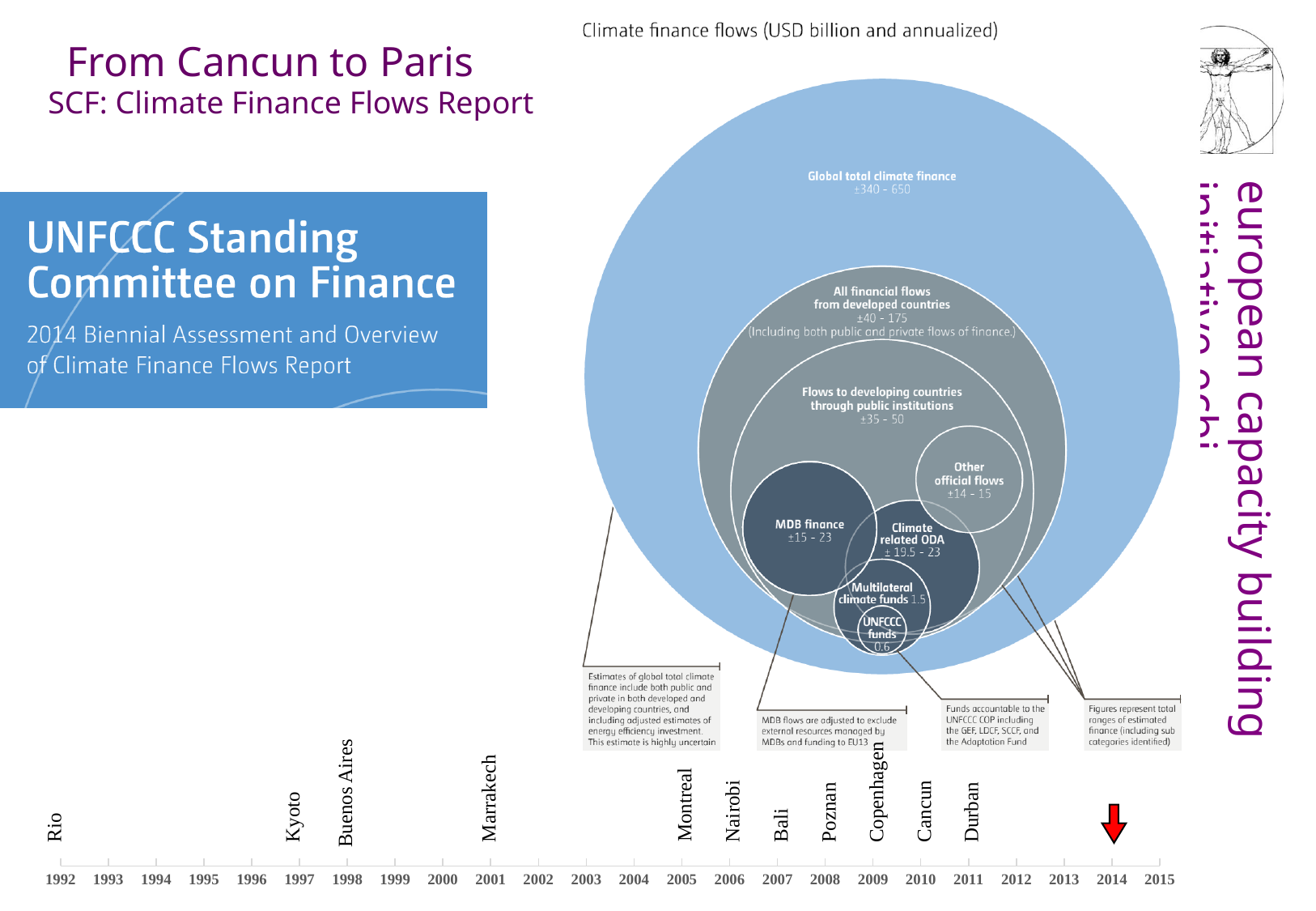
What value is printed for Multilateral climate funds? 1.5 Which is larger, Multilateral climate funds or UNFCCC funds? Multilateral climate funds What range is shown for Flows to developing countries through public institutions? ±35 - 50 What range is printed for All financial flows from developed countries? ±40 - 175 What is the range shown for Global total climate finance in the climate finance flows diagram? ±340 - 650 What range is shown for Climate related ODA? ± 19.5 - 23 In what units are the climate finance flows in the diagram expressed, according to its title? USD billion and annualized What is the difference between the Multilateral climate funds value and the UNFCCC funds value? 0.9 Which category in the diagram has the smallest value? UNFCCC funds Which category in the diagram has the largest value? Global total climate finance What range is given for MDB finance? ±15 - 23 What value is printed for UNFCCC funds? 0.6